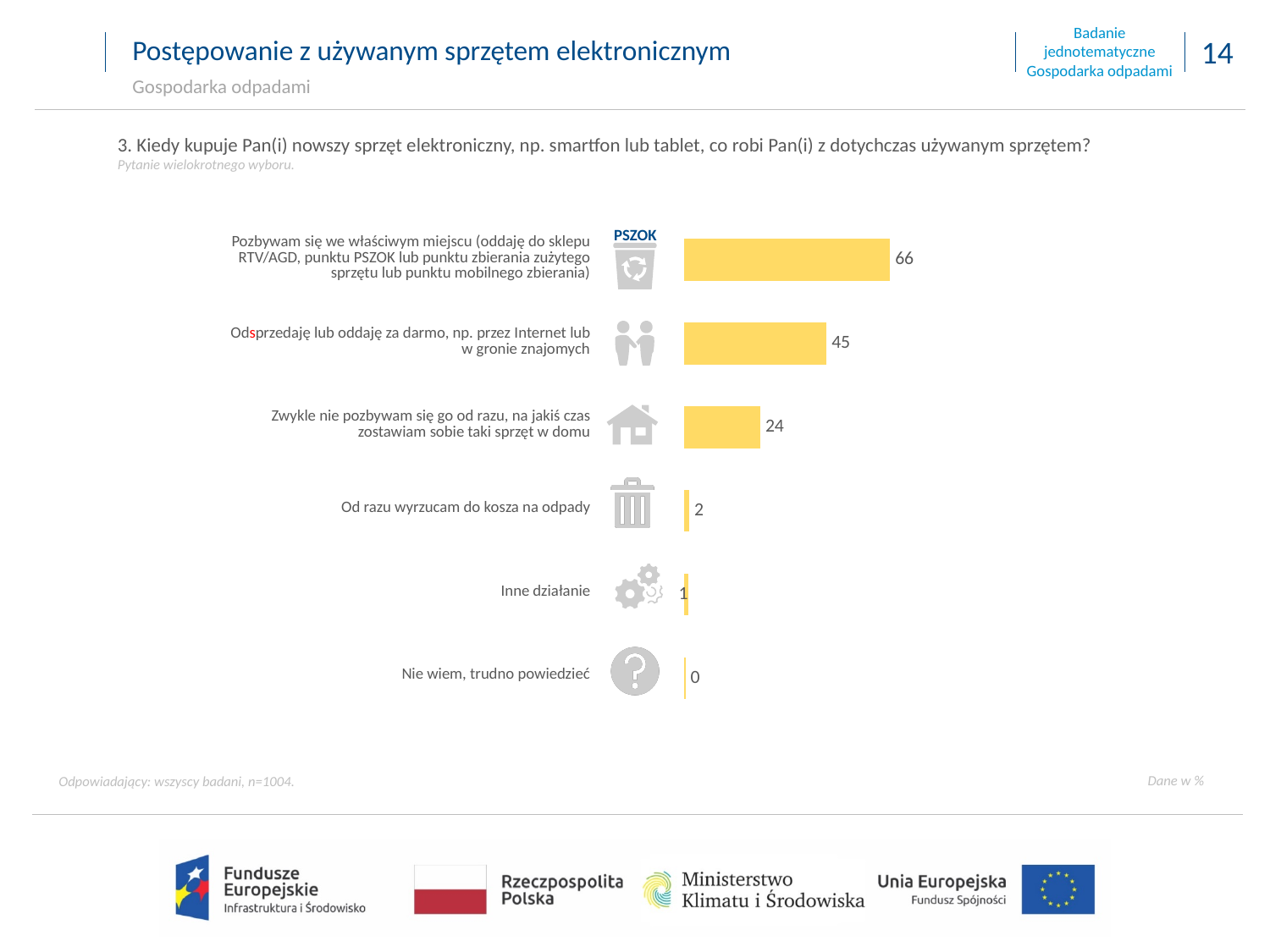
Which category has the lowest value? Nie wiem, trudno powiedzieć What value is shown for "Od razu wyrzucam do kosza na odpady"? 2 What is the difference between the value for "Pozbywam się we właściwym miejscu..." and the value for "Odsprzedaję lub oddaję za darmo..."? 21 How many categories are shown in the chart? 6 What value is shown for "Zwykle nie pozbywam się go od razu, na jakiś czas zostawiam sobie taki sprzęt w domu"? 24 Which is larger: the value for "Zwykle nie pozbywam się go od razu..." or the value for "Od razu wyrzucam do kosza na odpady"? Zwykle nie pozbywam się go od razu, na jakiś czas zostawiam sobie taki sprzęt w domu What value is shown for "Nie wiem, trudno powiedzieć"? 0 Which category has the highest value? Pozbywam się we właściwym miejscu (oddaję do sklepu RTV/AGD, punktu PSZOK lub punktu zbierania zużytego sprzętu lub punktu mobilnego zbierania) What is the sample size (n) stated in the note below the chart? n=1004 What is the difference between the value for "Odsprzedaję lub oddaję za darmo..." and the value for "Zwykle nie pozbywam się go od razu..."? 21 What kind of chart is shown on the slide? Bar chart What value is shown for "Odsprzedaję lub oddaję za darmo, np. przez Internet lub w gronie znajomych"? 45